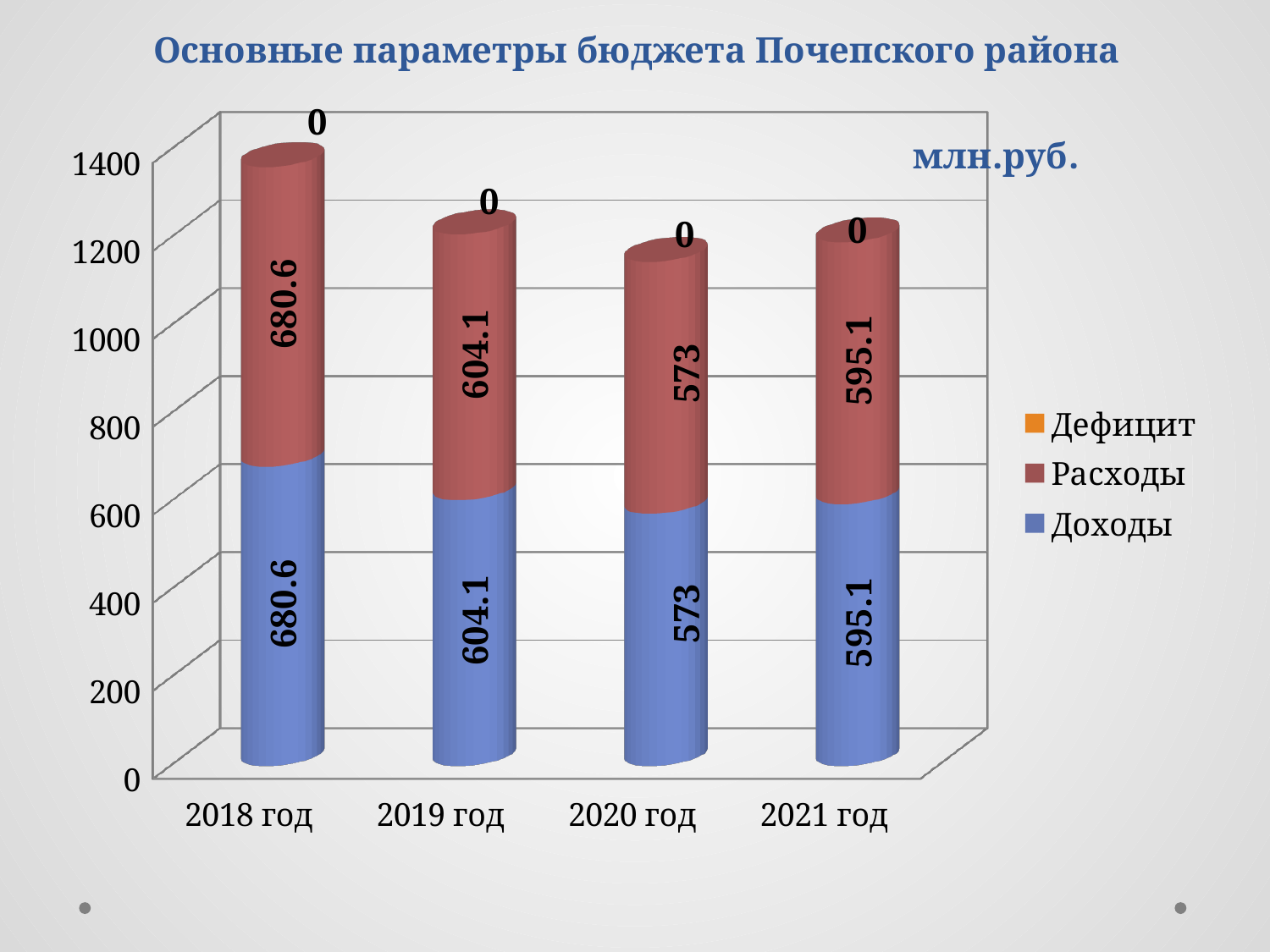
What is the value of Дефицит for 2021 год? 0 What is the value of Расходы for 2020 год? 573 Which year has the lowest value of Расходы? 2020 год How many years are shown on the x axis? 4 What kind of chart is shown on the slide? Stacked bar chart What is the title of the chart? Основные параметры бюджета Почепского района Which is larger: Расходы in 2021 год or Расходы in 2020 год? 2021 год What is the total of the stacked bar for 2019 год? 1208.2 Which year has the highest value of Доходы? 2018 год How many series does the legend list? 3 What is the value of Доходы for 2018 год? 680.6 What is the difference between Доходы in 2018 год and Доходы in 2019 год? 76.5